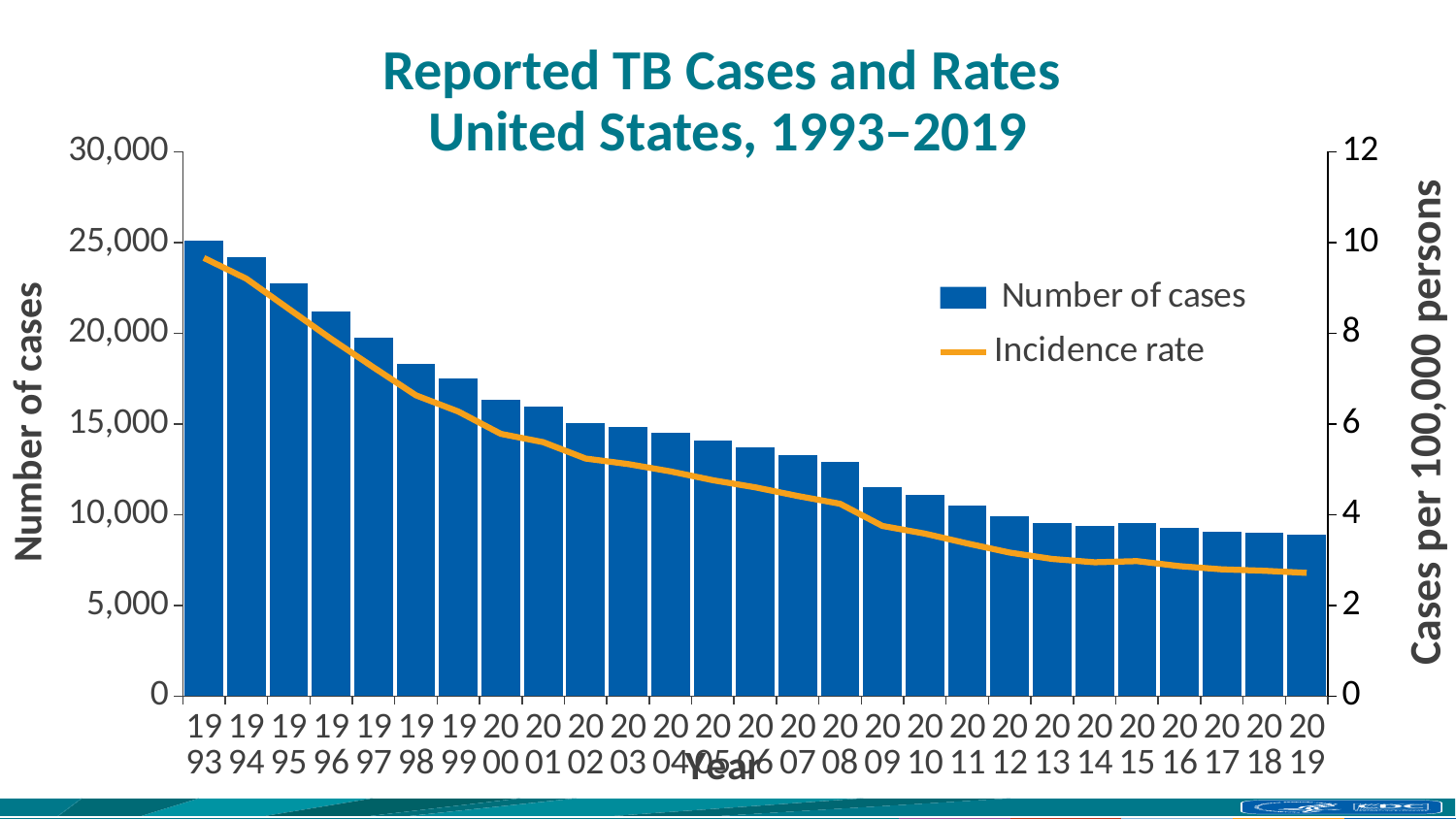
Is the number of cases for 2000 greater or less than 15,000? greater Is the number of cases for 2019 greater or less than 10,000? less Is the incidence rate for 1993 greater or less than 8 cases per 100,000 persons? greater Which year has the highest number of cases? 1993 Which year has more reported cases, 1995 or 2005? 1995 What is the label of the right-hand vertical axis? Cases per 100,000 persons What kind of chart is shown on the slide? A combined bar and line chart How many series does the legend list? 2 Do the number of cases rise or fall from 1993 to 2019? Fall How many years are plotted along the x axis? 27